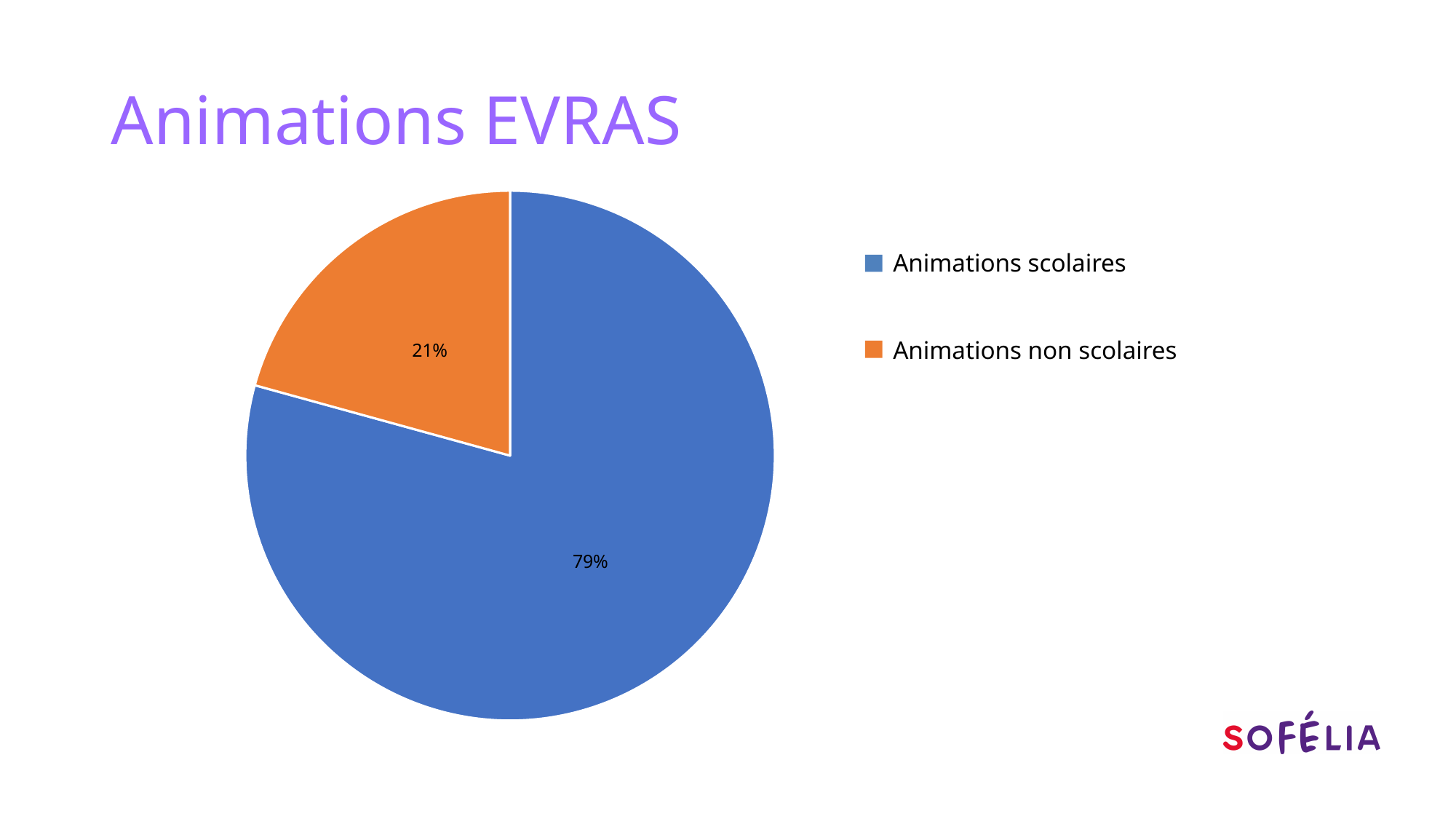
How many slices does the pie chart have? 2 Which category has the smallest slice of the pie? Animations non scolaires Which category has the largest slice of the pie? Animations scolaires Which is larger, Animations scolaires or Animations non scolaires? Animations scolaires What is the difference in percentage points between Animations scolaires and Animations non scolaires? 58 What is the title of the slide containing the chart? Animations EVRAS What share of the pie is Animations non scolaires? 21% What share of the pie is Animations scolaires? 79% What kind of chart is shown on the slide? pie chart How many entries does the legend list? 2 What colour is the slice for Animations non scolaires? orange